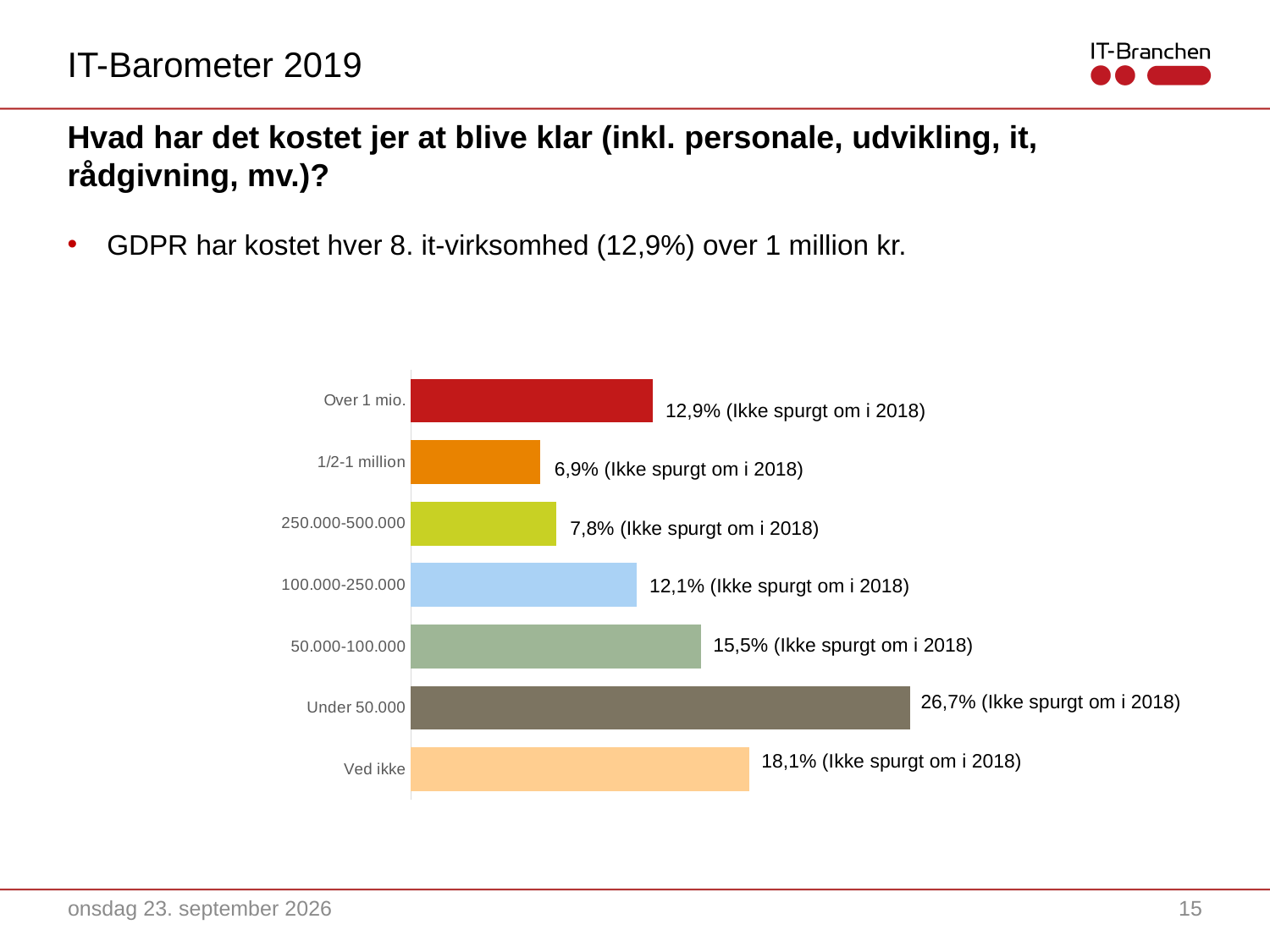
Which category has the lowest value? 1/2-1 million What is the value for "Ved ikke"? 18,1% What kind of chart is shown on the slide? Bar chart What is the value for "Over 1 mio."? 12,9% What note is appended to every data label in the chart? (Ikke spurgt om i 2018) What is the difference between the values for "Under 50.000" and "Ved ikke"? 8,6% Which category has the highest value? Under 50.000 What is the value for "Under 50.000"? 26,7% What is the value for "250.000-500.000"? 7,8% Which is larger, the value for "Over 1 mio." or the value for "100.000-250.000"? Over 1 mio. What is the difference between the values for "50.000-100.000" and "100.000-250.000"? 3,4% How many categories are shown in the chart? 7